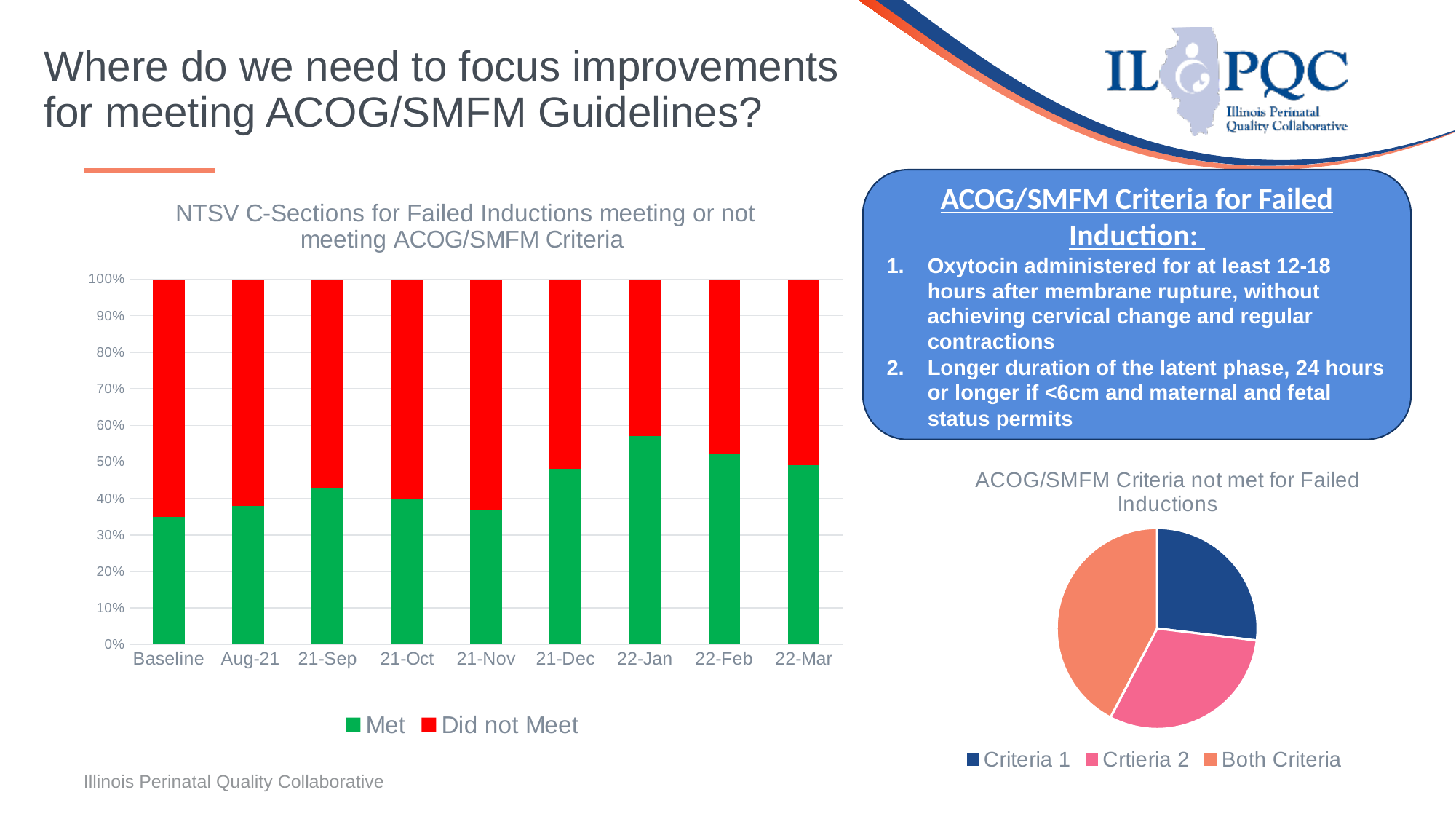
In the 'NTSV C-Sections for Failed Inductions' bar chart, is the 'Met' value for 22-Jan greater or less than 50%? greater In the 'NTSV C-Sections for Failed Inductions' bar chart, is the 'Met' value for 21-Sep greater or less than 40%? greater In the 'NTSV C-Sections for Failed Inductions' bar chart, which is larger for 22-Feb: 'Met' or 'Did not Meet'? Met In the 'NTSV C-Sections for Failed Inductions' bar chart, how many categories are shown on the x axis? 9 In the 'NTSV C-Sections for Failed Inductions' bar chart, how many series does the legend list? 2 In the 'NTSV C-Sections for Failed Inductions' bar chart, is the 'Met' value for Baseline greater or less than 40%? less In the 'ACOG/SMFM Criteria not met for Failed Inductions' pie chart, how many slices are there? 3 What kind of chart is the 'ACOG/SMFM Criteria not met for Failed Inductions' chart? pie chart What kind of chart is the 'NTSV C-Sections for Failed Inductions meeting or not meeting ACOG/SMFM Criteria' chart? bar chart In the 'NTSV C-Sections for Failed Inductions' bar chart, which month has the highest 'Met' share? 22-Jan In the 'ACOG/SMFM Criteria not met for Failed Inductions' pie chart, which slice is the largest? Both Criteria In the 'NTSV C-Sections for Failed Inductions' bar chart, what colour represents 'Did not Meet'? red